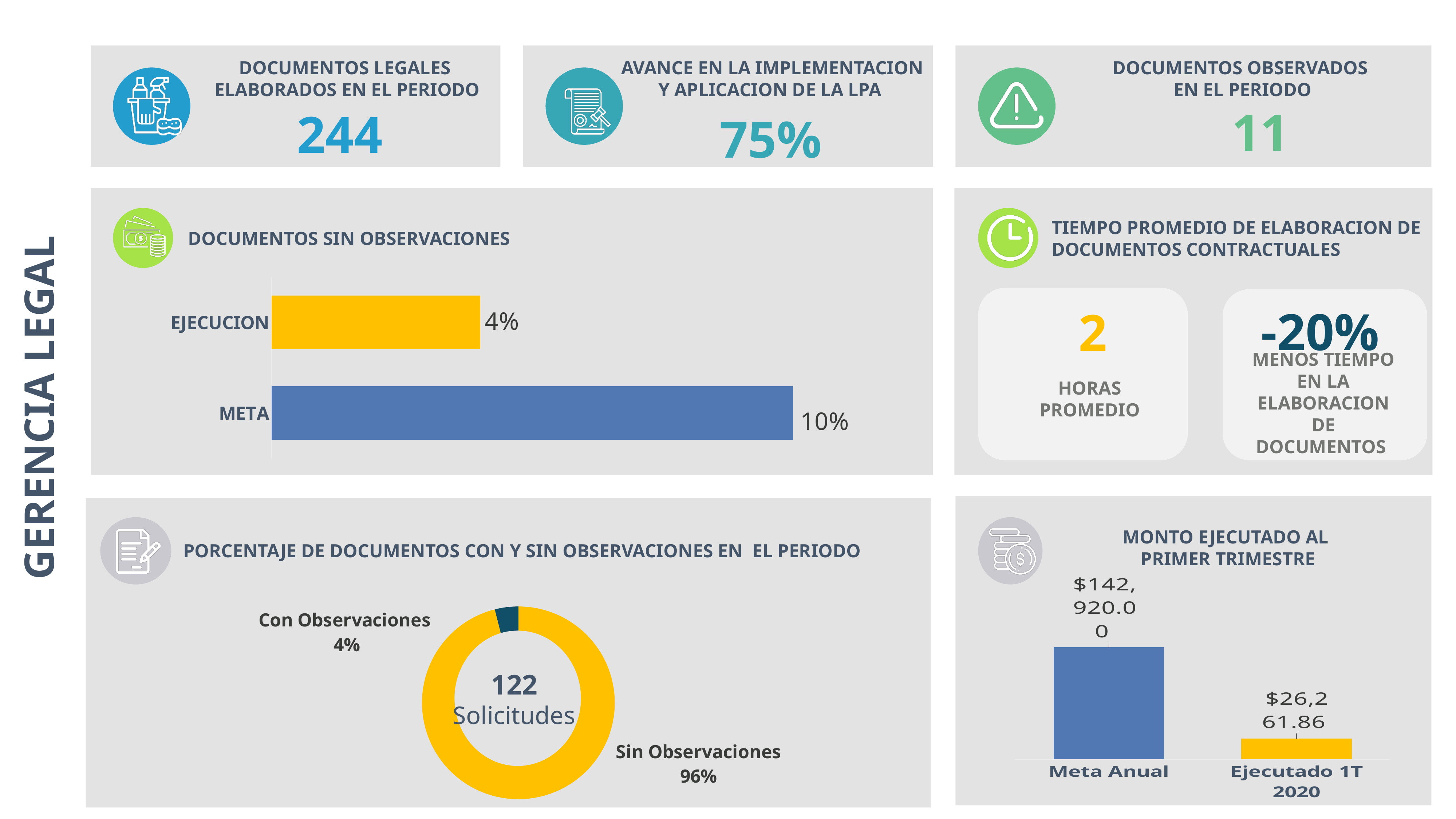
In the 'DOCUMENTOS SIN OBSERVACIONES' bar chart, what is the value for EJECUCION? 4% In the donut chart 'PORCENTAJE DE DOCUMENTOS CON Y SIN OBSERVACIONES EN EL PERIODO', what share is 'Con Observaciones'? 4% In the 'DOCUMENTOS SIN OBSERVACIONES' bar chart, what is the difference between META and EJECUCION? 6% In the 'DOCUMENTOS SIN OBSERVACIONES' bar chart, which category has the higher value? META In the 'MONTO EJECUTADO AL PRIMER TRIMESTRE' bar chart, what is the value for Ejecutado 1T 2020? $26,261.86 What kind of chart is used for 'DOCUMENTOS SIN OBSERVACIONES'? Bar chart What number of solicitudes is shown in the centre of the donut chart 'PORCENTAJE DE DOCUMENTOS CON Y SIN OBSERVACIONES EN EL PERIODO'? 122 In the 'MONTO EJECUTADO AL PRIMER TRIMESTRE' bar chart, which category has the lower value? Ejecutado 1T 2020 In the 'DOCUMENTOS SIN OBSERVACIONES' bar chart, what is the value for META? 10% In the 'MONTO EJECUTADO AL PRIMER TRIMESTRE' bar chart, what is the value for Meta Anual? $142,920.00 In the donut chart 'PORCENTAJE DE DOCUMENTOS CON Y SIN OBSERVACIONES EN EL PERIODO', what share is 'Sin Observaciones'? 96% How many slices does the donut chart 'PORCENTAJE DE DOCUMENTOS CON Y SIN OBSERVACIONES EN EL PERIODO' have? 2